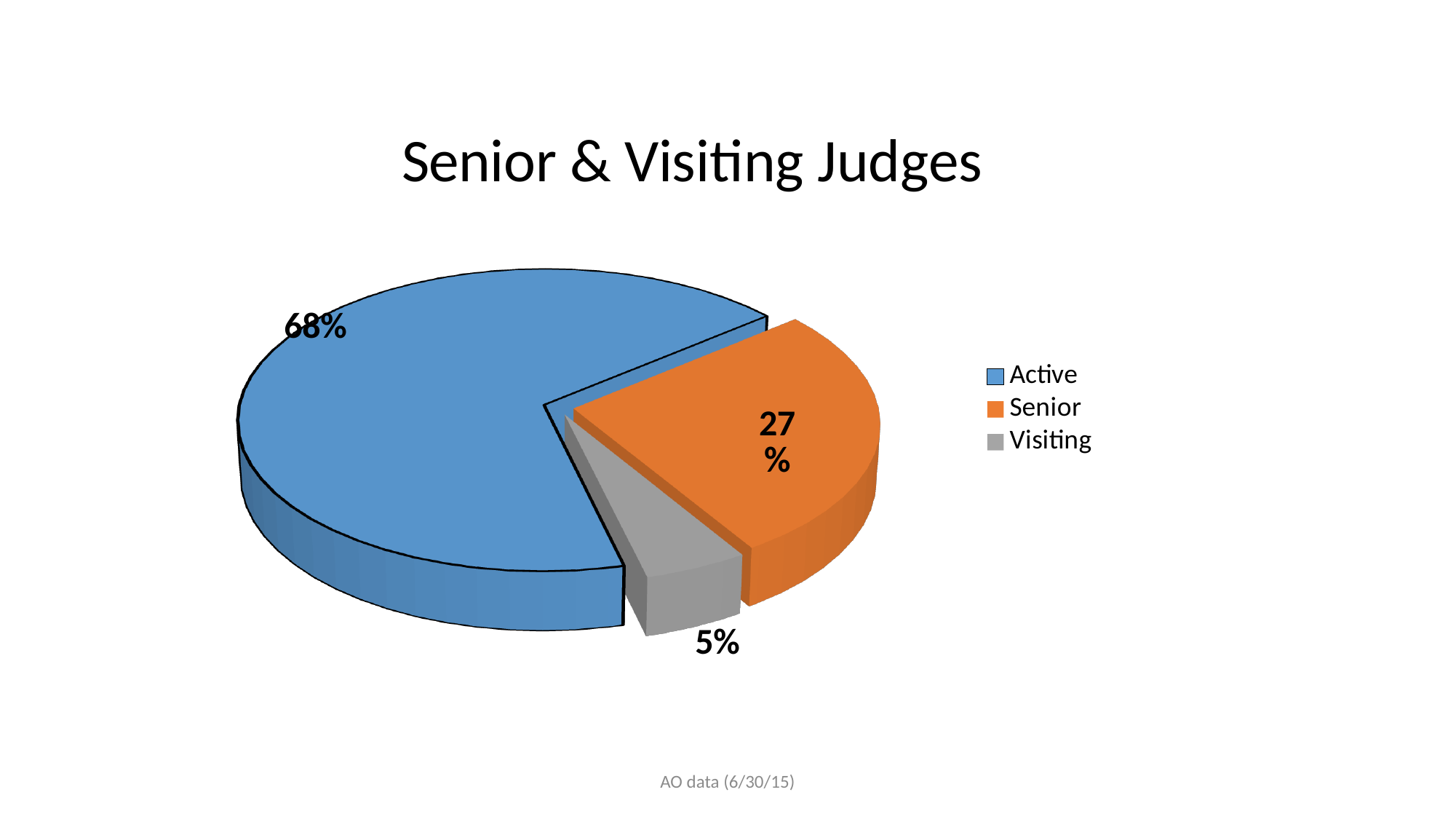
What kind of chart is shown on the slide? Pie chart What share of the pie does the Senior slice represent? 27% Which category has the largest slice of the pie? Active What share of the pie does the Active slice represent? 68% What colour is the Senior slice in the pie chart? Orange What is the difference in percentage points between the Active and Senior slices? 41 Which category has the smallest slice of the pie? Visiting How many categories are shown in the pie chart? 3 What is the difference in percentage points between the Senior and Visiting slices? 22 What share of the pie does the Visiting slice represent? 5% Which slice is larger, Senior or Visiting? Senior What is the title of the chart? Senior & Visiting Judges